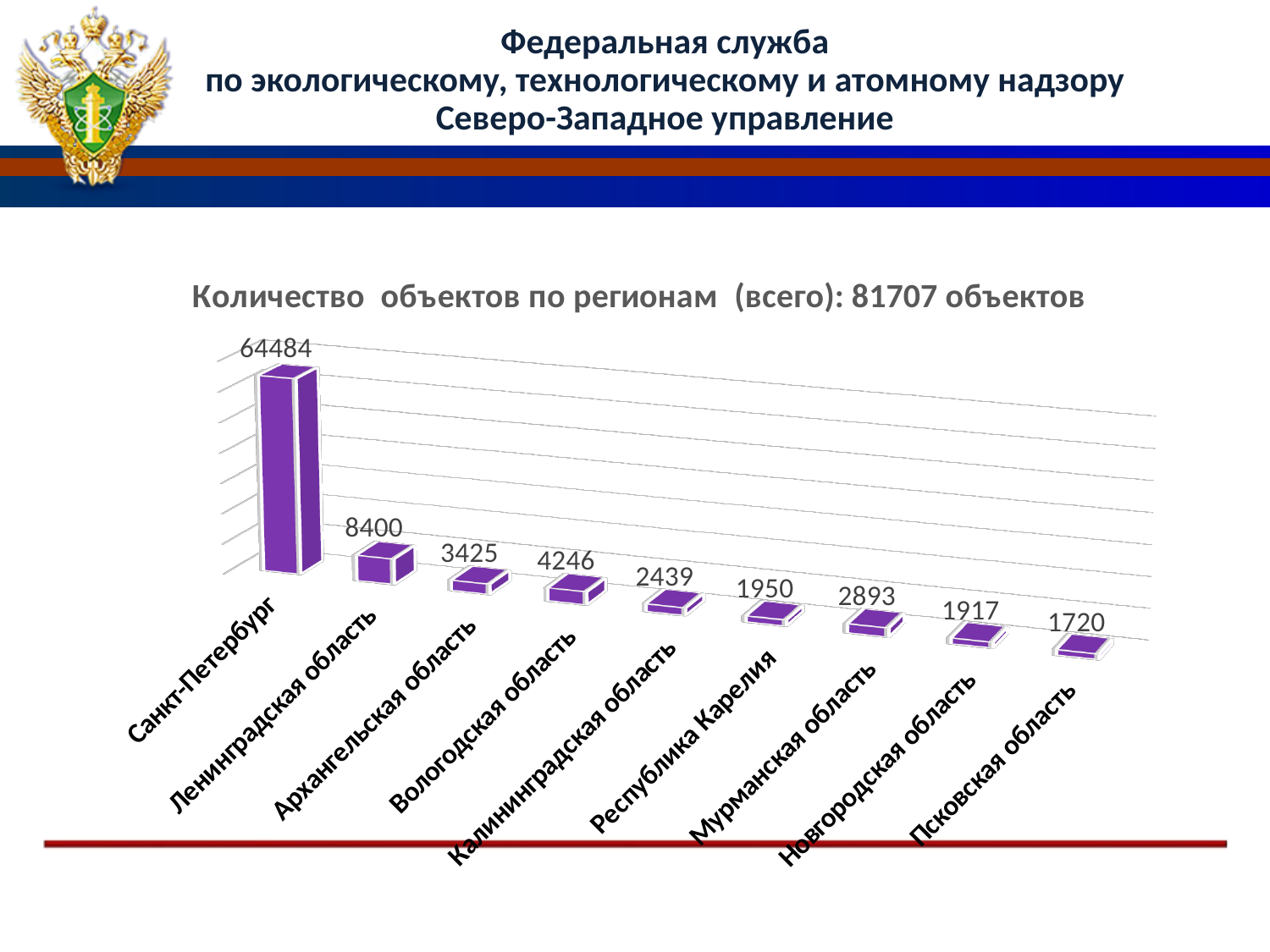
What is the number of objects for Мурманская область? 2893 What kind of chart is shown on the slide? Bar chart How many regions are shown in the chart? 9 Which region has the highest number of objects? Санкт-Петербург Which region has the lowest number of objects? Псковская область What is the number of objects for Вологодская область? 4246 What is the number of objects for Псковская область? 1720 What is the difference between the values for Республика Карелия and Новгородская область? 33 What total number of objects is stated in the chart title? 81707 объектов What is the number of objects for Санкт-Петербург? 64484 What is the difference between the values for Ленинградская область and Архангельская область? 4975 Which is larger, the value for Вологодская область or the value for Архангельская область? Вологодская область